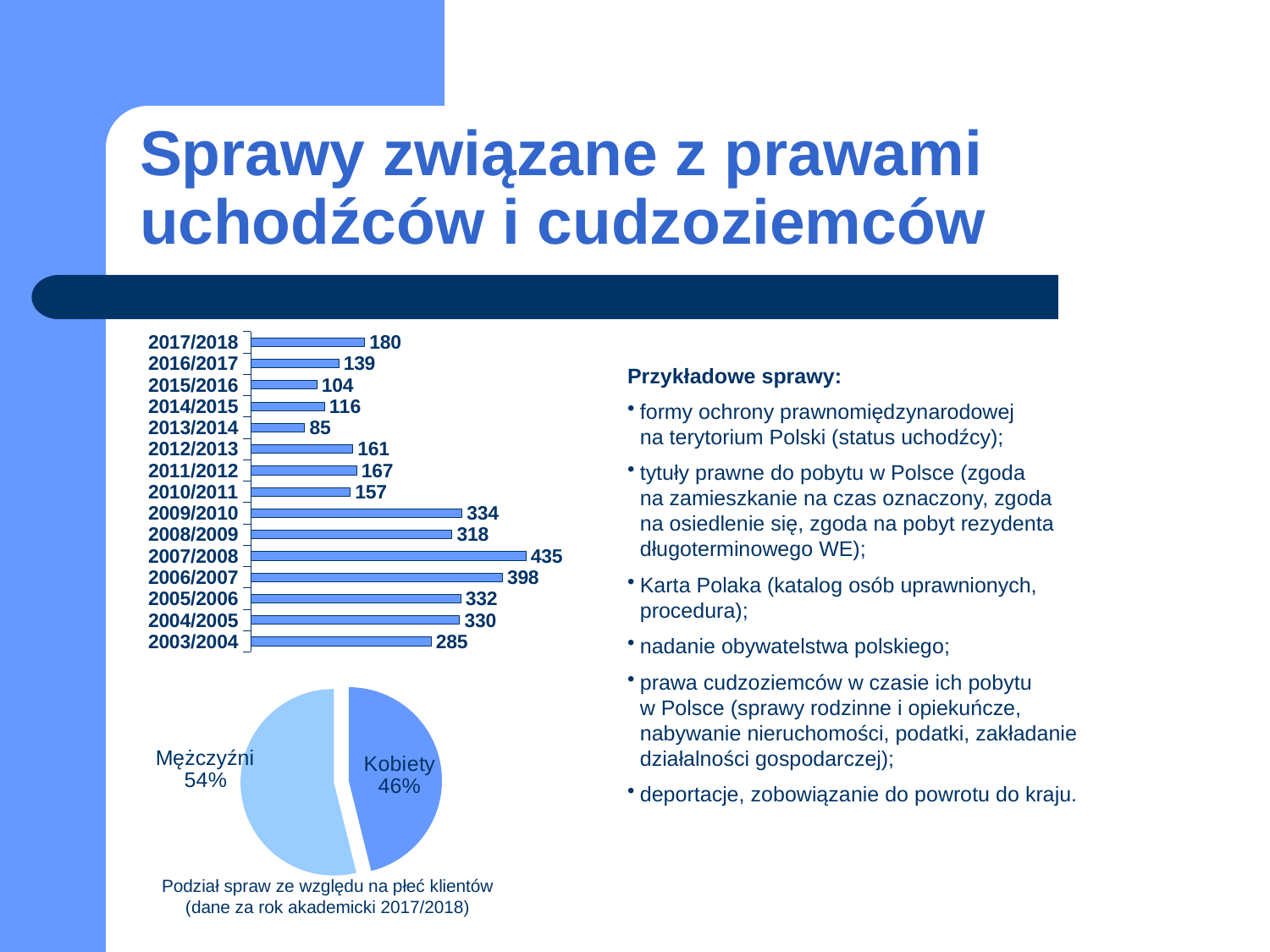
In the bar chart at the top left, how many academic years are shown? 15 What is the caption below the pie chart at the bottom left? Podział spraw ze względu na płeć klientów (dane za rok akademicki 2017/2018) In the bar chart at the top left, what is the value for 2013/2014? 85 In the bar chart at the top left, which academic year has the highest value? 2007/2008 In the bar chart at the top left, what is the value for 2007/2008? 435 In the pie chart at the bottom left, what share is Kobiety? 46% In the bar chart at the top left, which is larger, the value for 2006/2007 or the value for 2005/2006? 2006/2007 In the bar chart at the top left, which academic year has the lowest value? 2013/2014 What kind of chart is the chart at the top left of the slide? bar chart In the bar chart at the top left, what is the value for 2017/2018? 180 In the pie chart at the bottom left, which slice is larger, Mężczyźni or Kobiety? Mężczyźni In the bar chart at the top left, what is the difference between the values for 2009/2010 and 2008/2009? 16